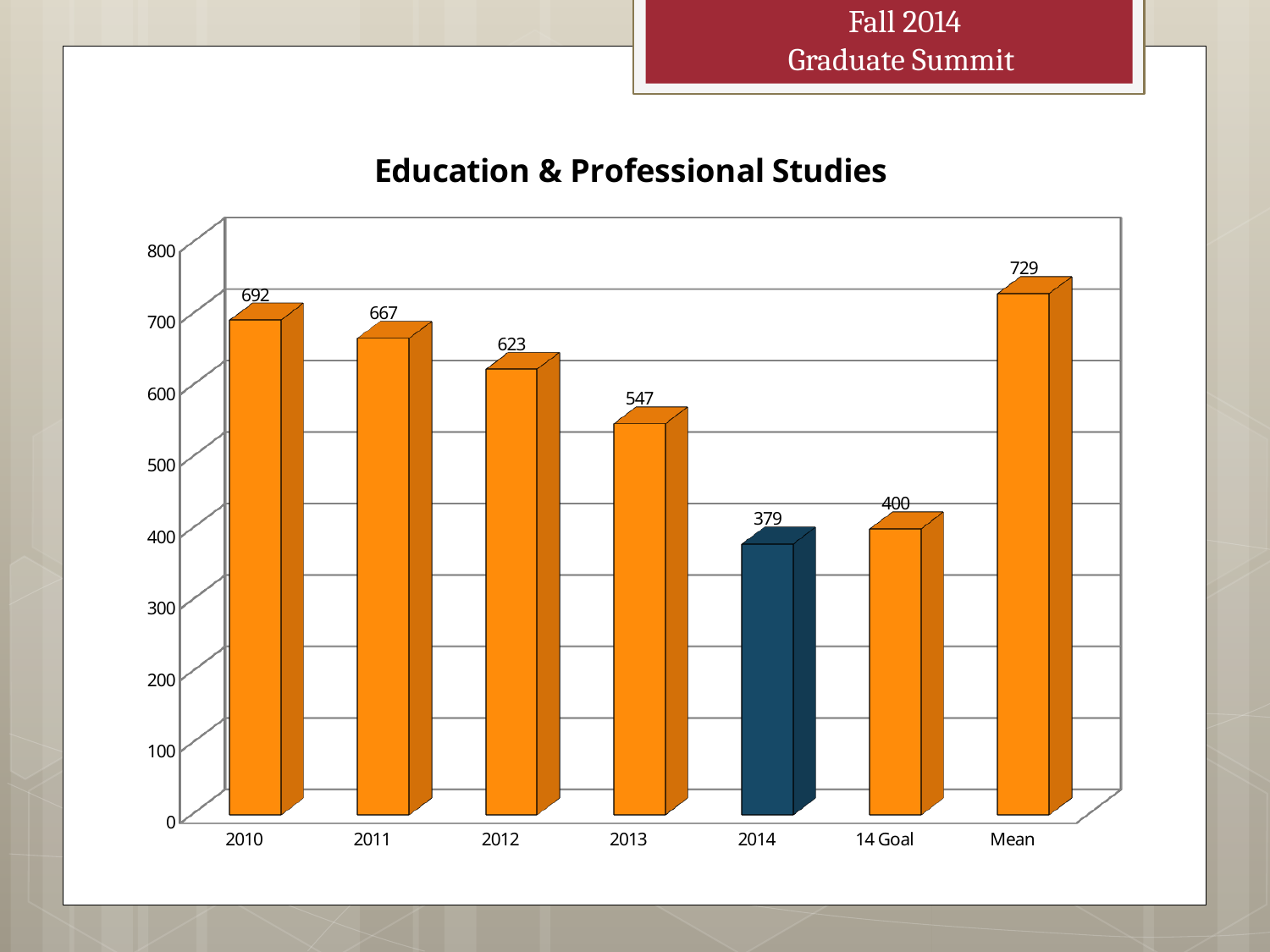
Do the values rise or fall from 2010 to 2014? Fall What is the value for 14 Goal? 400 Which category has the lowest value? 2014 What is the value for 2014? 379 What is the difference between the values for 2010 and 2014? 313 What is the difference between the 14 Goal value and the 2014 value? 21 Which is larger, the value for 2011 or the value for 2012? 2011 What is the value for Mean? 729 How many bars are shown in the chart? 7 What is the value for 2010? 692 Which category has the highest value? Mean What kind of chart is this? Bar chart